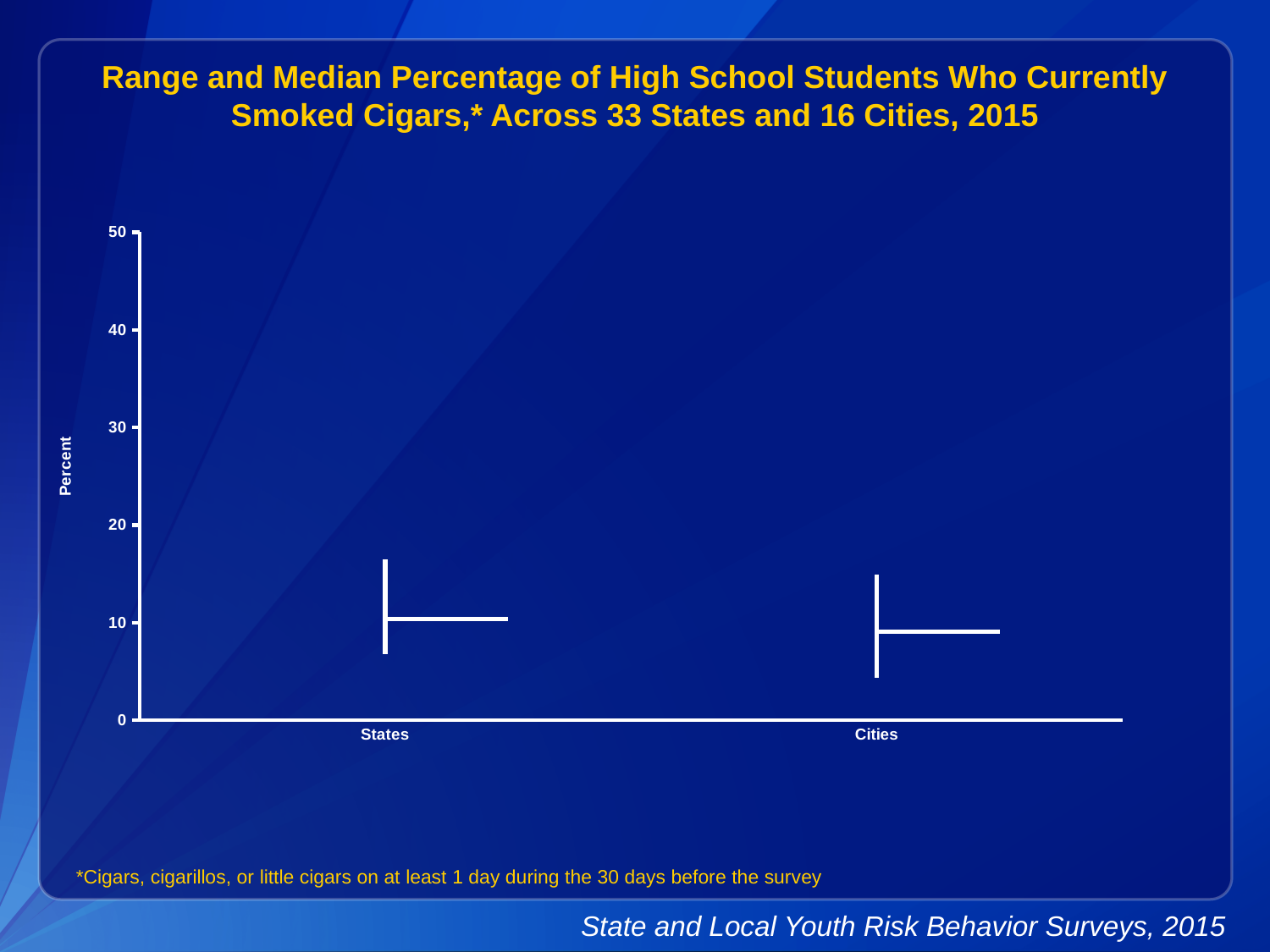
Is the top of the range for Cities greater or less than 20? less Is the top of the range for States greater or less than 20? less How many categories are shown on the x axis of the chart? 2 Which category has the lower bottom of its range, States or Cities? Cities What is the label of the y axis? Percent Is the bottom of the range for Cities greater or less than 10? less Which category has the higher median value, States or Cities? States What is the highest value shown on the y axis? 50 What are the two categories shown on the x axis? States and Cities